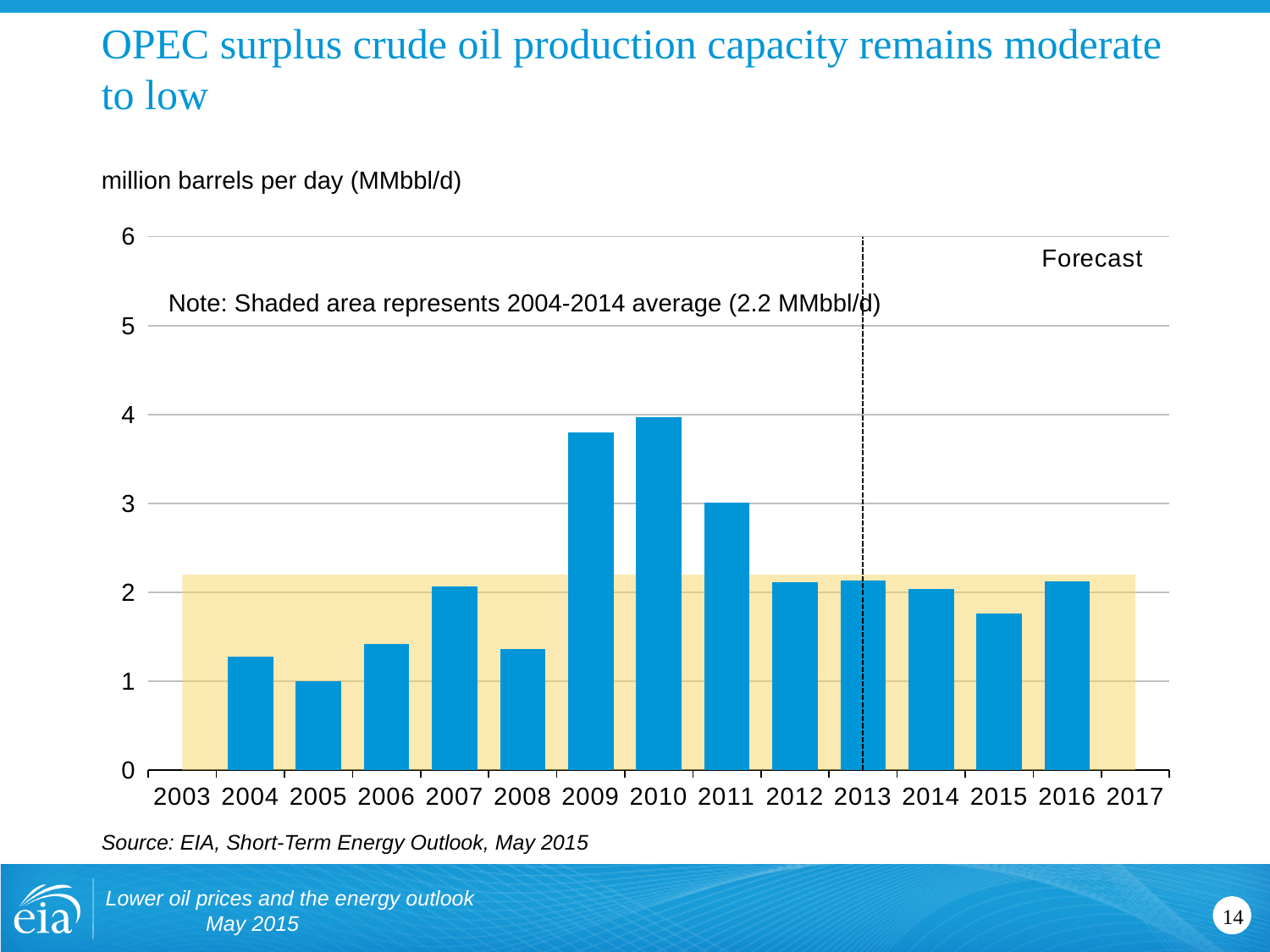
Which year has the larger value, 2009 or 2011? 2009 Is the value for 2010 greater or less than 5? less Is the value for 2008 greater or less than 2? less Is the value for 2009 greater or less than 3? greater Which year has the larger value, 2015 or 2016? 2016 Do the values rise or fall from 2010 to 2012? fall Which year has the lowest OPEC surplus crude oil production capacity? 2005 What kind of chart is shown on the slide? bar chart How many years have bars plotted on the chart? 13 According to the note on the chart, what is the 2004-2014 average represented by the shaded area? 2.2 MMbbl/d Which year has the highest OPEC surplus crude oil production capacity? 2010